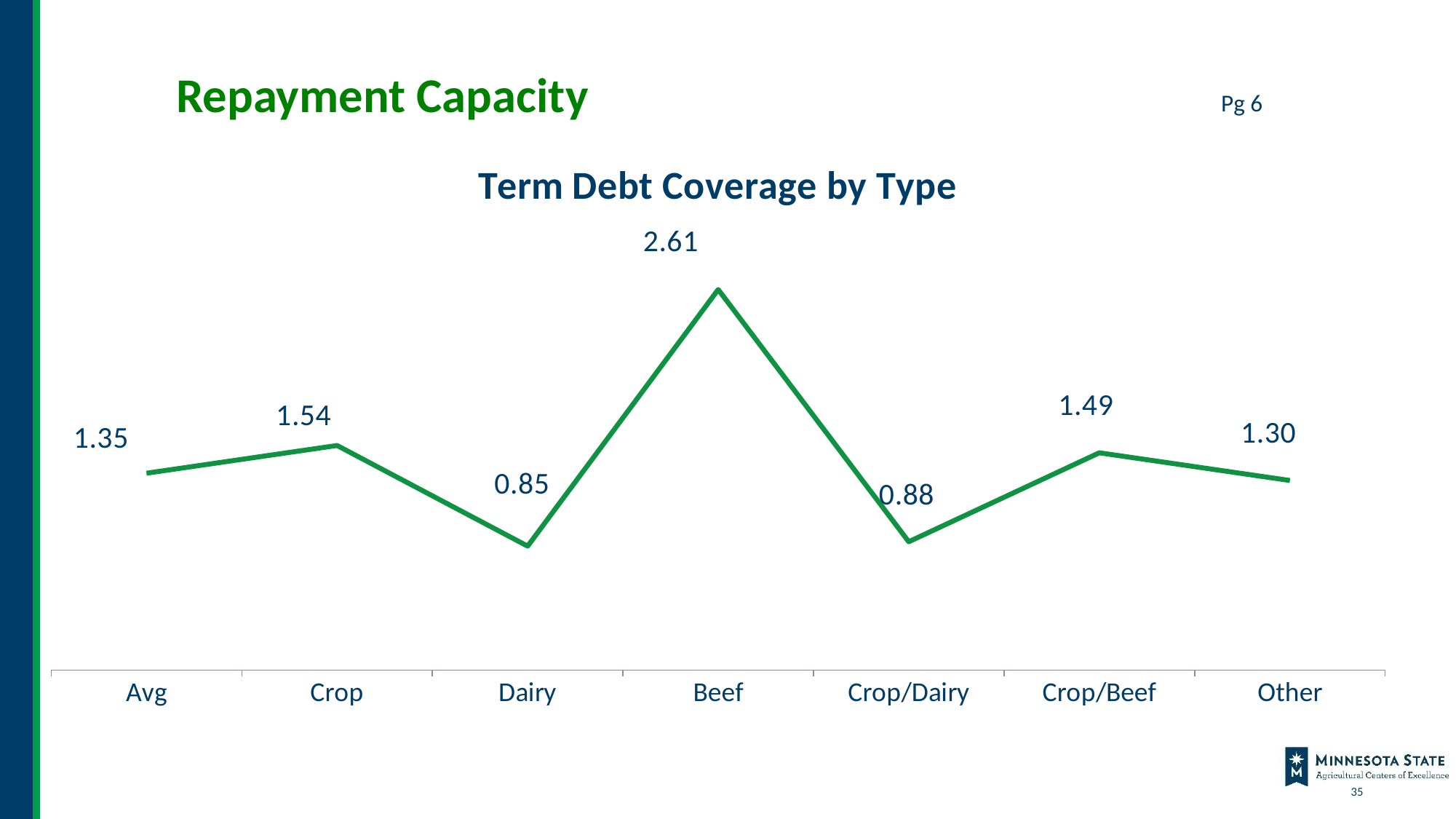
Which type has the lowest term debt coverage? Dairy What is the difference between the term debt coverage for Crop/Beef and for Other? 0.19 Which type has the highest term debt coverage? Beef How many types are plotted on the chart? 7 What is the difference between the term debt coverage for Beef and for Crop? 1.07 What is the term debt coverage value for Crop/Beef? 1.49 What kind of chart is shown on the slide? Line chart What is the term debt coverage value for Dairy? 0.85 What is the term debt coverage value for Avg? 1.35 What is the title of the chart? Term Debt Coverage by Type What is the term debt coverage value for Beef? 2.61 Which has a larger term debt coverage, Crop or Other? Crop